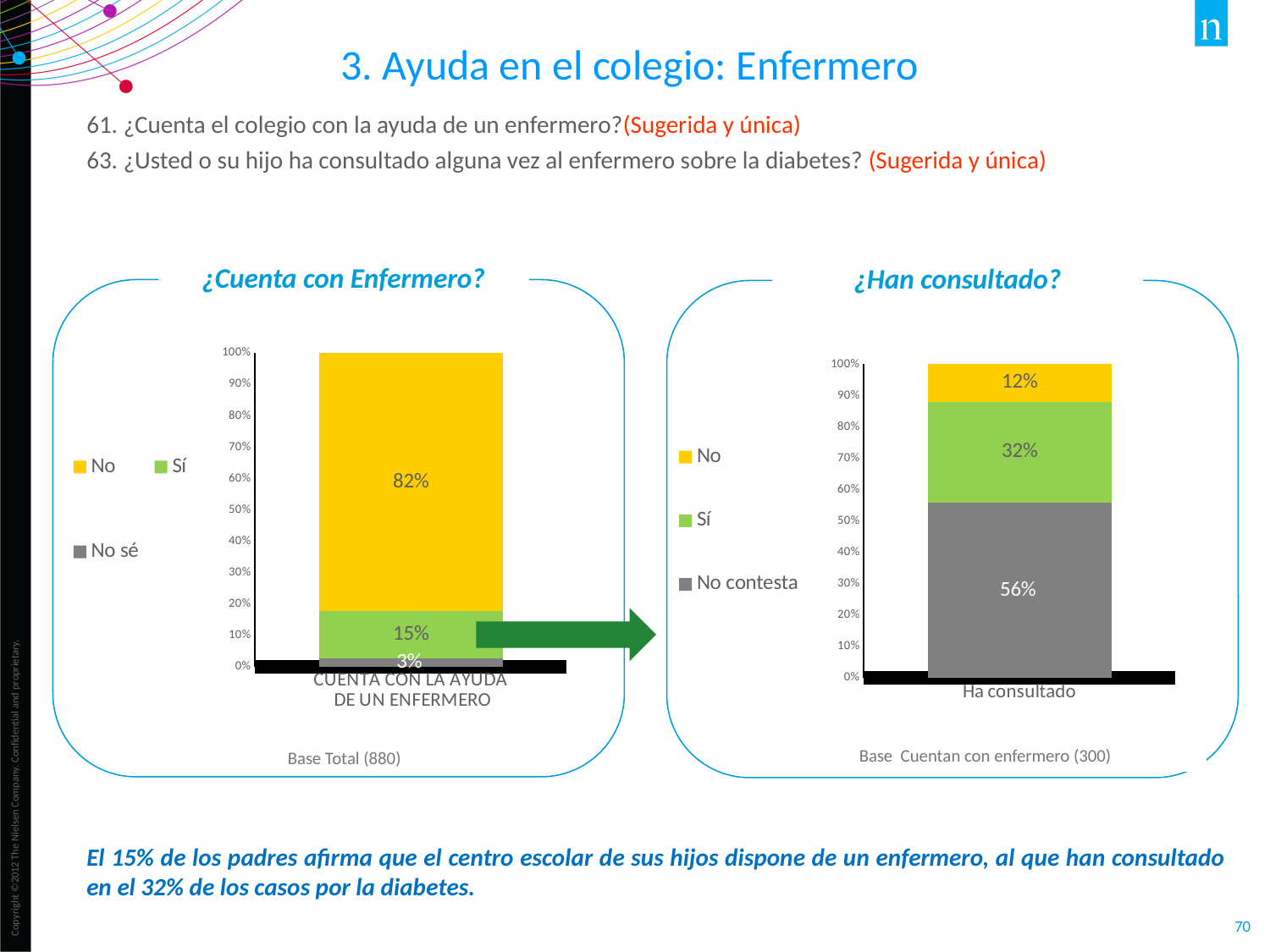
How many series does the legend of the '¿Han consultado?' chart list? 3 In the '¿Cuenta con Enfermero?' chart, which response has the smallest share? No sé In the '¿Han consultado?' chart, what percentage is shown for 'Sí'? 32% In the '¿Han consultado?' chart, which response has the largest share? No contesta In the '¿Cuenta con Enfermero?' chart, what percentage is shown for 'No sé'? 3% In the '¿Cuenta con Enfermero?' chart, what is the difference between the 'No' and 'Sí' percentages? 67% What type of chart is the '¿Cuenta con Enfermero?' chart? Stacked bar chart In the '¿Cuenta con Enfermero?' chart, what percentage is shown for 'No'? 82% In the '¿Han consultado?' chart, what percentage is shown for 'No contesta'? 56% In the '¿Han consultado?' chart, which is larger, 'Sí' or 'No'? Sí In the '¿Han consultado?' chart, what percentage is shown for 'No'? 12% In the '¿Cuenta con Enfermero?' chart, what percentage is shown for 'Sí'? 15%